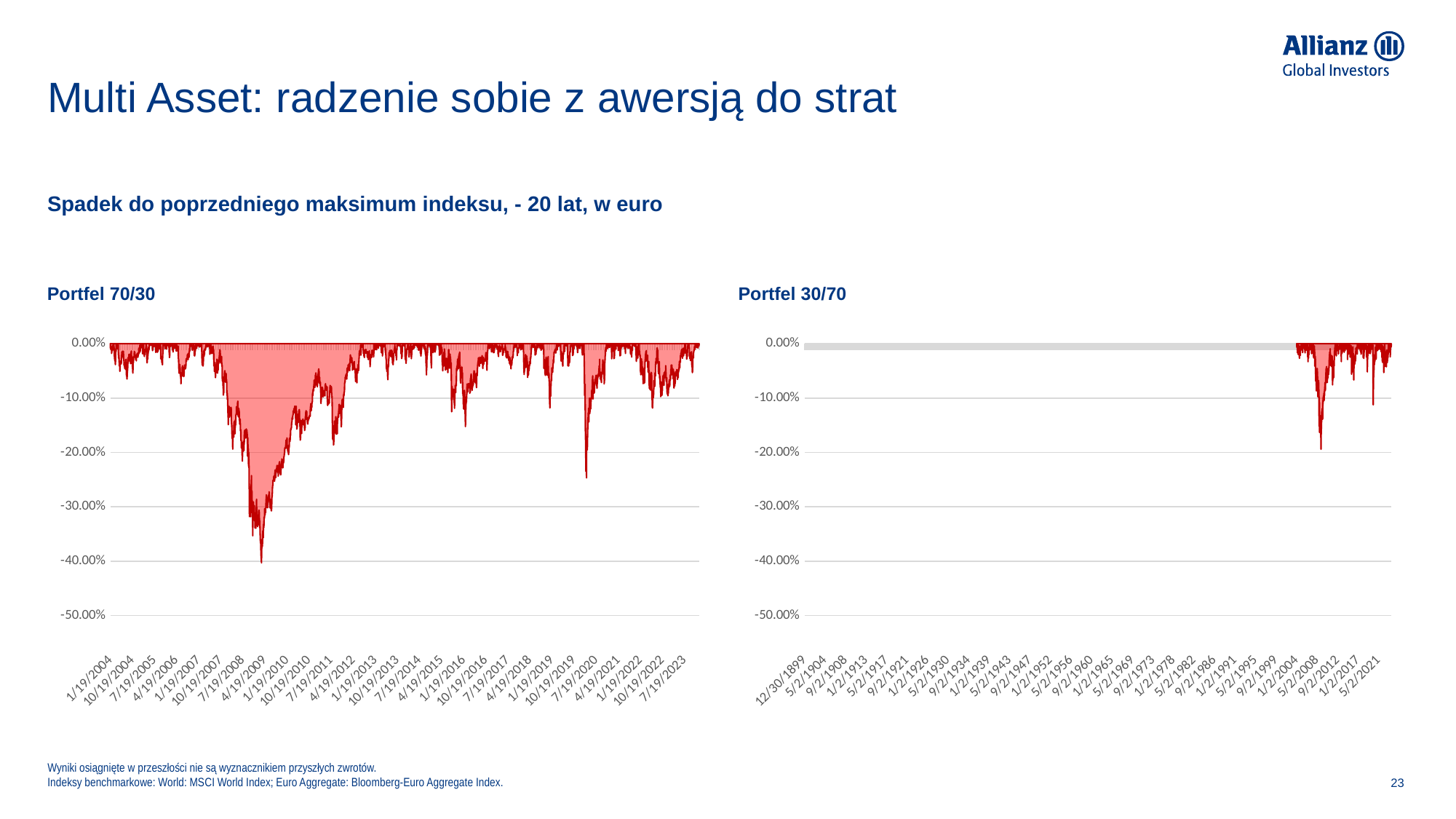
What kind of chart is the 'Portfel 70/30' chart? Area chart What kind of chart is the 'Portfel 30/70' chart? Area chart How many charts are shown on the slide? 2 Which chart shows the deeper maximum drawdown, 'Portfel 70/30' or 'Portfel 30/70'? Portfel 70/30 What is the first date label on the x axis of the 'Portfel 70/30' chart? 1/19/2004 What is the lowest value labelled on the y axis of the 'Portfel 70/30' chart? -50.00% In the 'Portfel 70/30' chart, is the lowest value reached around 2020 greater or less than -10.00%? less In the 'Portfel 30/70' chart, is the lowest value reached around 2008 greater or less than -10.00%? less In the 'Portfel 30/70' chart, is the lowest value reached around 2008 greater or less than -30.00%? greater